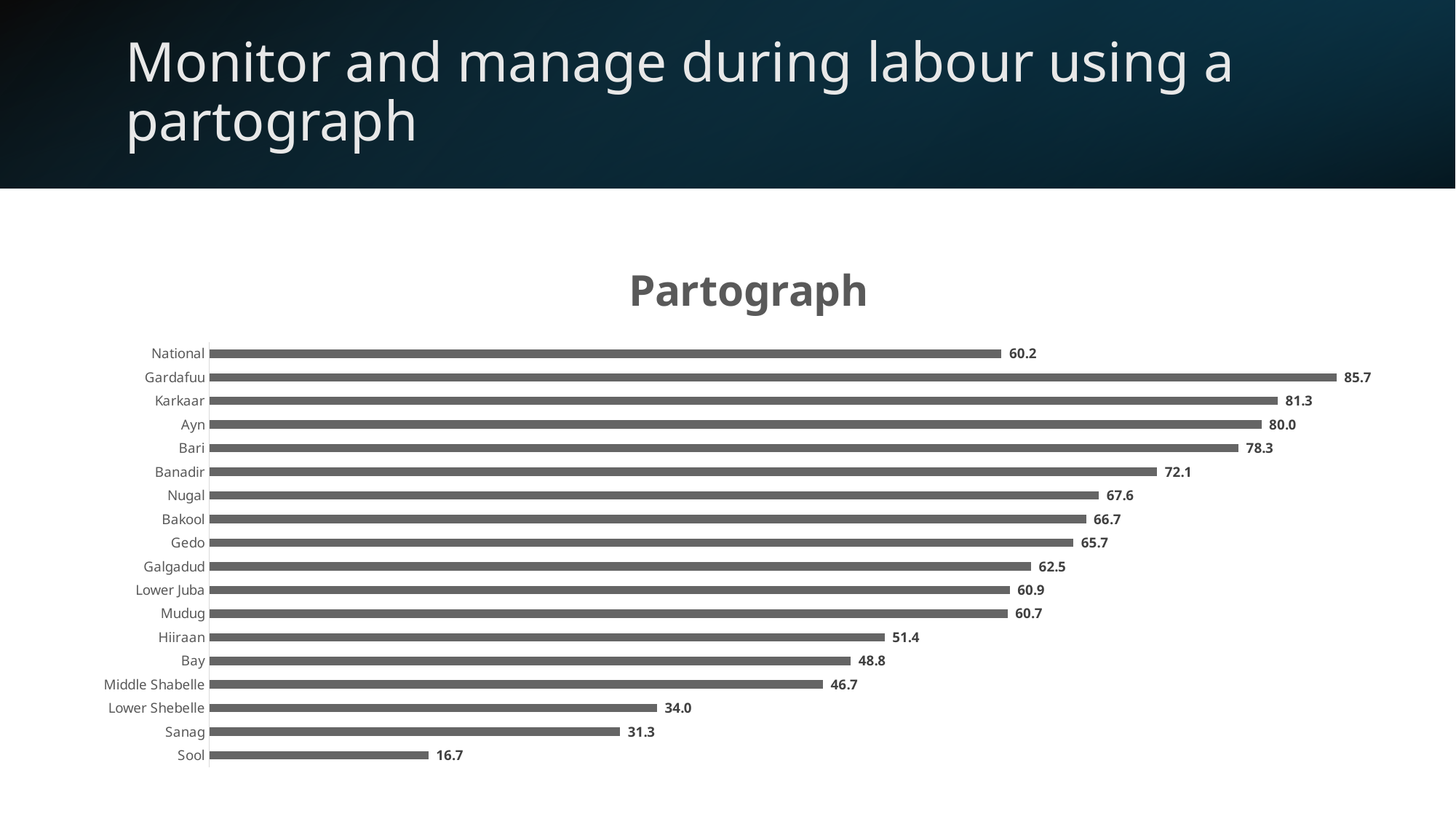
Which category has the highest value? Gardafuu What is the title of the chart? Partograph How many categories are plotted in the chart? 18 Which is larger, the value for Sanag or the value for Middle Shabelle? Middle Shabelle What is the value for National in the Partograph chart? 60.2 What is the value for Banadir? 72.1 What is the difference between the values for Karkaar and Ayn? 1.3 What kind of chart is shown on the slide? Bar chart Which category has the lowest value? Sool What is the difference between the values for Gardafuu and Sool? 69.0 What is the value for Lower Shebelle? 34.0 Which is larger, the value for Hiiraan or the value for Bay? Hiiraan